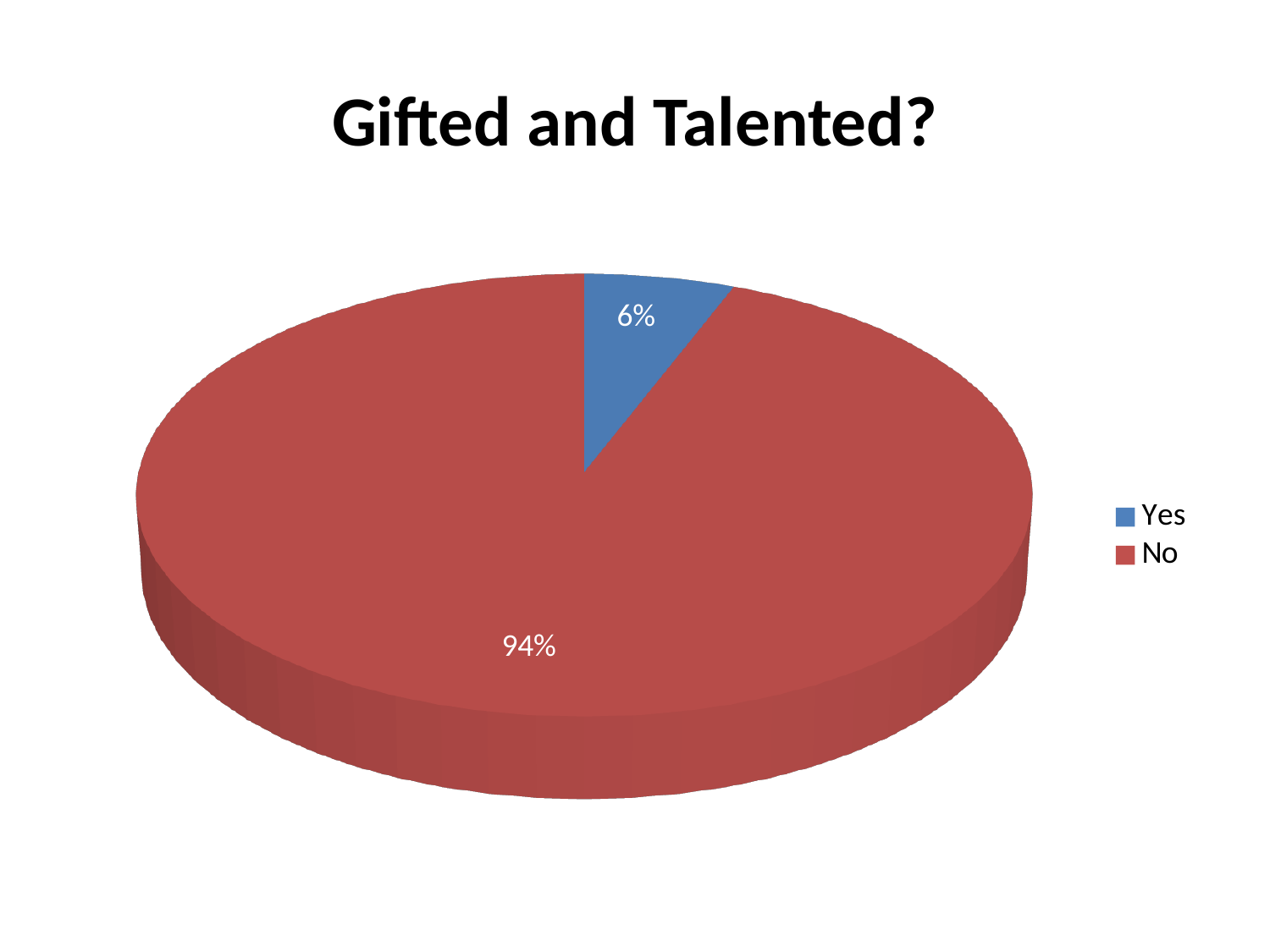
Which is larger, the "Yes" slice or the "No" slice? No How many entries does the legend list? 2 What is the difference in percentage points between the "No" slice and the "Yes" slice? 88 What share of the pie is labelled "Yes"? 6% Which category has the smallest slice of the pie? Yes What share of the pie is labelled "No"? 94% What colour is the "Yes" slice? blue What kind of chart is shown on the slide? pie chart Which category has the largest slice of the pie? No How many categories does the pie chart show? 2 What is the title of the chart? Gifted and Talented?